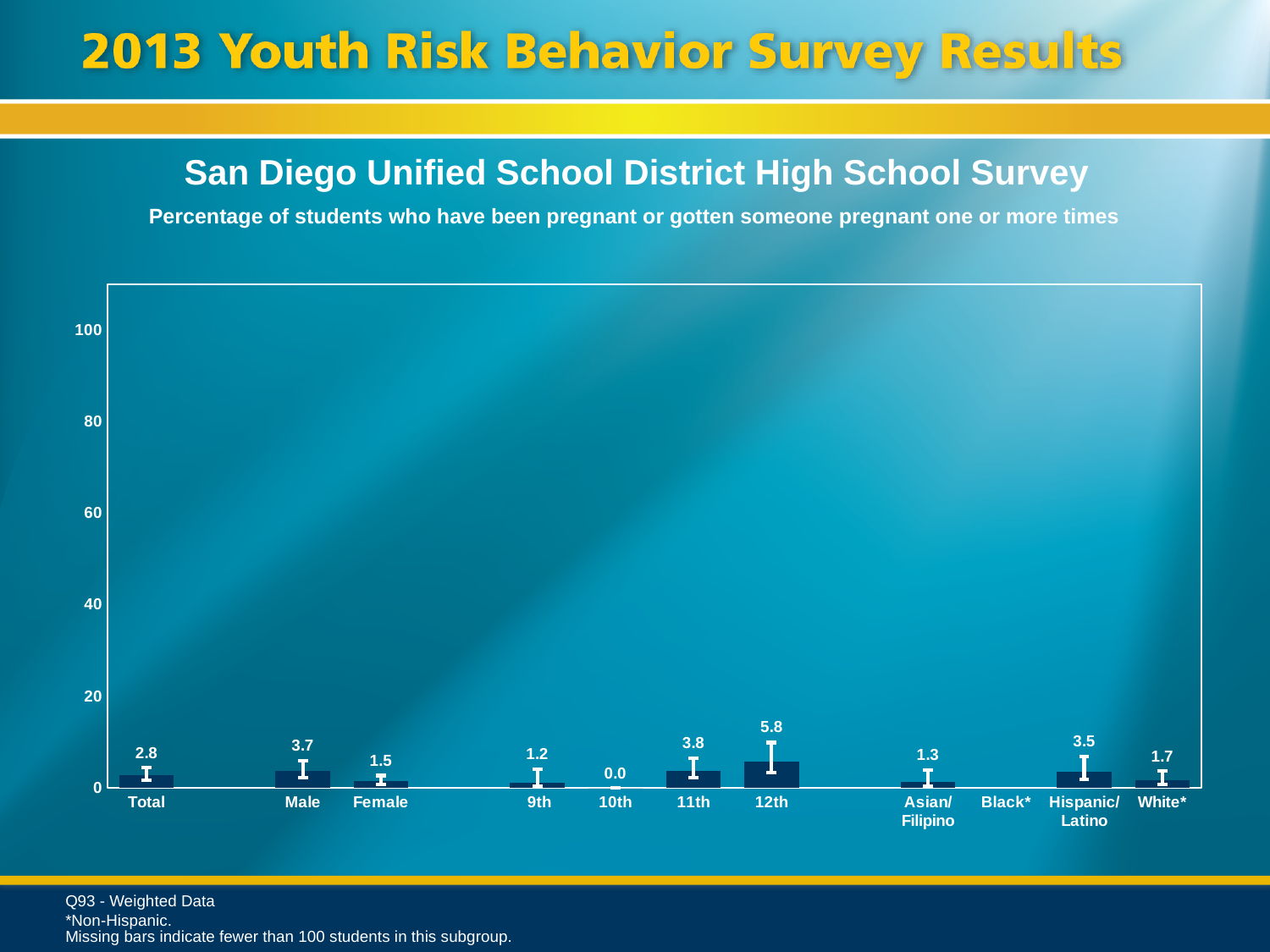
Is the value for 12th grade greater or less than 20? less What is the value for 12th grade? 5.8 Which category with a printed value has the lowest value? 10th Which is larger, the value for Hispanic/Latino or the value for White*? Hispanic/Latino Which category has the highest value? 12th What is the value for Male? 3.7 What is the value for Total? 2.8 Which category has no bar shown? Black* What kind of chart is shown? bar chart What is the difference between the Male and Female values? 2.2 What is the value for Asian/Filipino? 1.3 How many categories are labeled on the x axis? 11